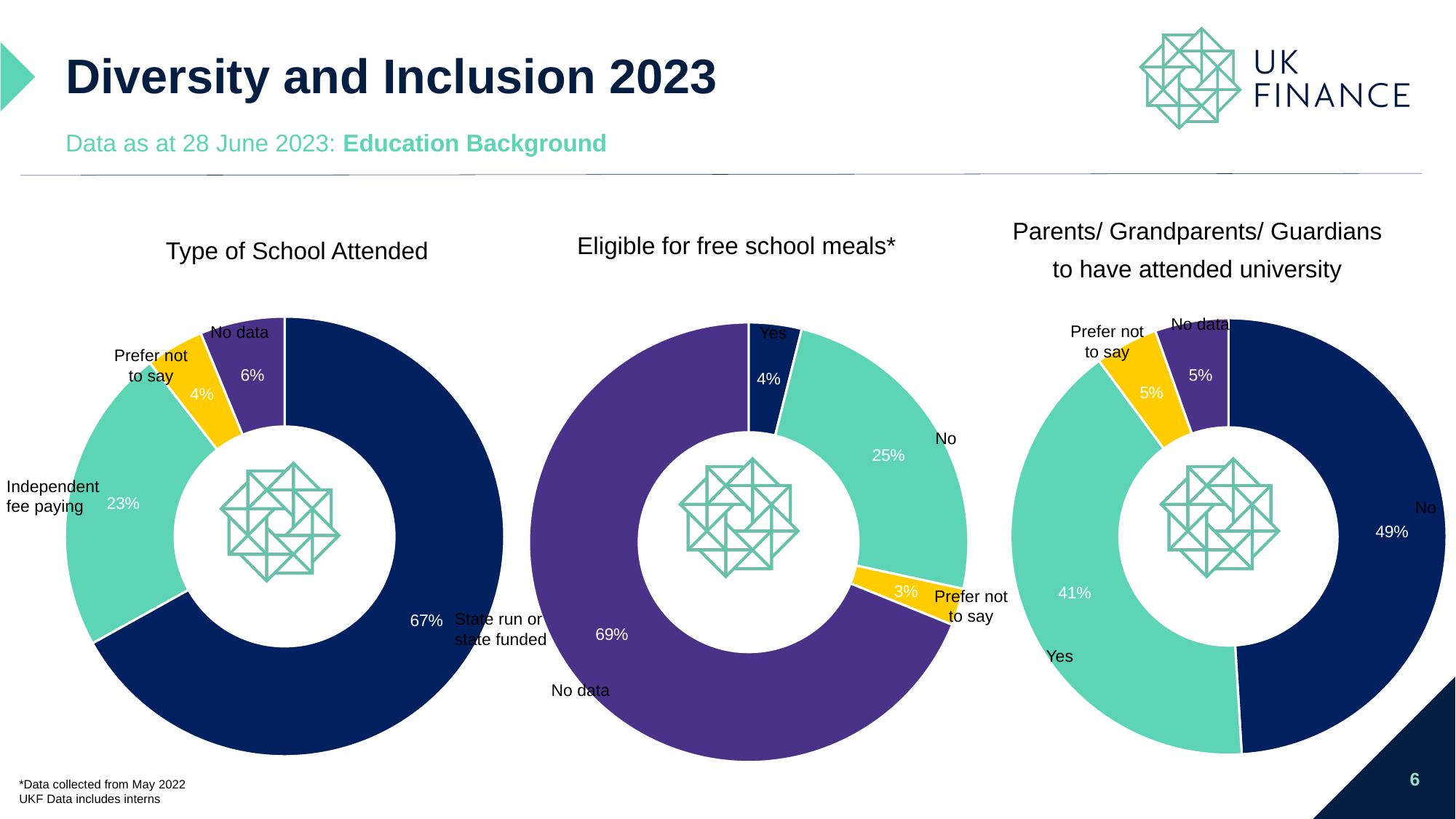
In the 'Type of School Attended' chart, what percentage attended a state run or state funded school? 67% In the 'Type of School Attended' chart, what is the difference between the state run or state funded share and the independent fee paying share? 44 percentage points In the 'Parents/ Grandparents/ Guardians to have attended university' chart, what is the difference between the 'No' and 'Yes' shares? 8 percentage points What type of chart is used for 'Type of School Attended'? Pie (donut) chart In the 'Eligible for free school meals*' chart, what percentage is 'No data'? 69% In the 'Parents/ Grandparents/ Guardians to have attended university' chart, what percentage answered 'No'? 49% In the 'Eligible for free school meals*' chart, what percentage answered 'Yes'? 4% In the 'Eligible for free school meals*' chart, how many categories are shown? 4 In the 'Parents/ Grandparents/ Guardians to have attended university' chart, which category has the largest share? No In the 'Type of School Attended' chart, what percentage attended an independent fee paying school? 23% In the 'Type of School Attended' chart, which category has the smallest share? Prefer not to say In the 'Eligible for free school meals*' chart, which is larger: 'No' or 'Prefer not to say'? No